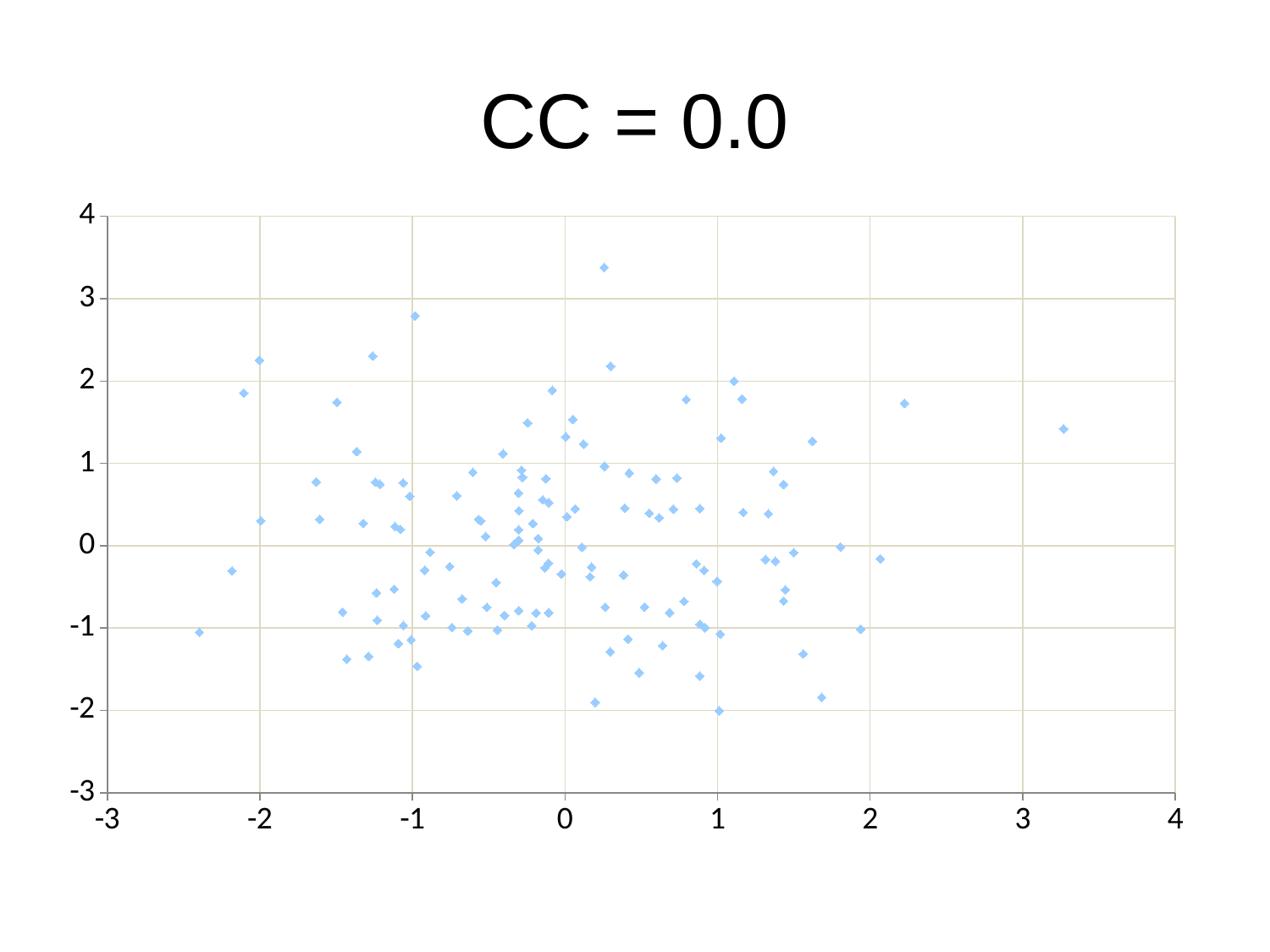
What is the title of the chart? CC = 0.0 What is the minimum value shown on the y axis? -3 Is the y value of the lowest point on the chart greater or less than -1? less Do the y values show a clear rising or falling trend as x increases? no clear trend Is the y value of the highest point on the chart greater or less than 3? greater What kind of chart is shown on the slide? scatter plot What is the maximum value shown on the x axis? 4 Is the x value of the rightmost point on the chart greater or less than 3? greater Does the chart have a legend? no